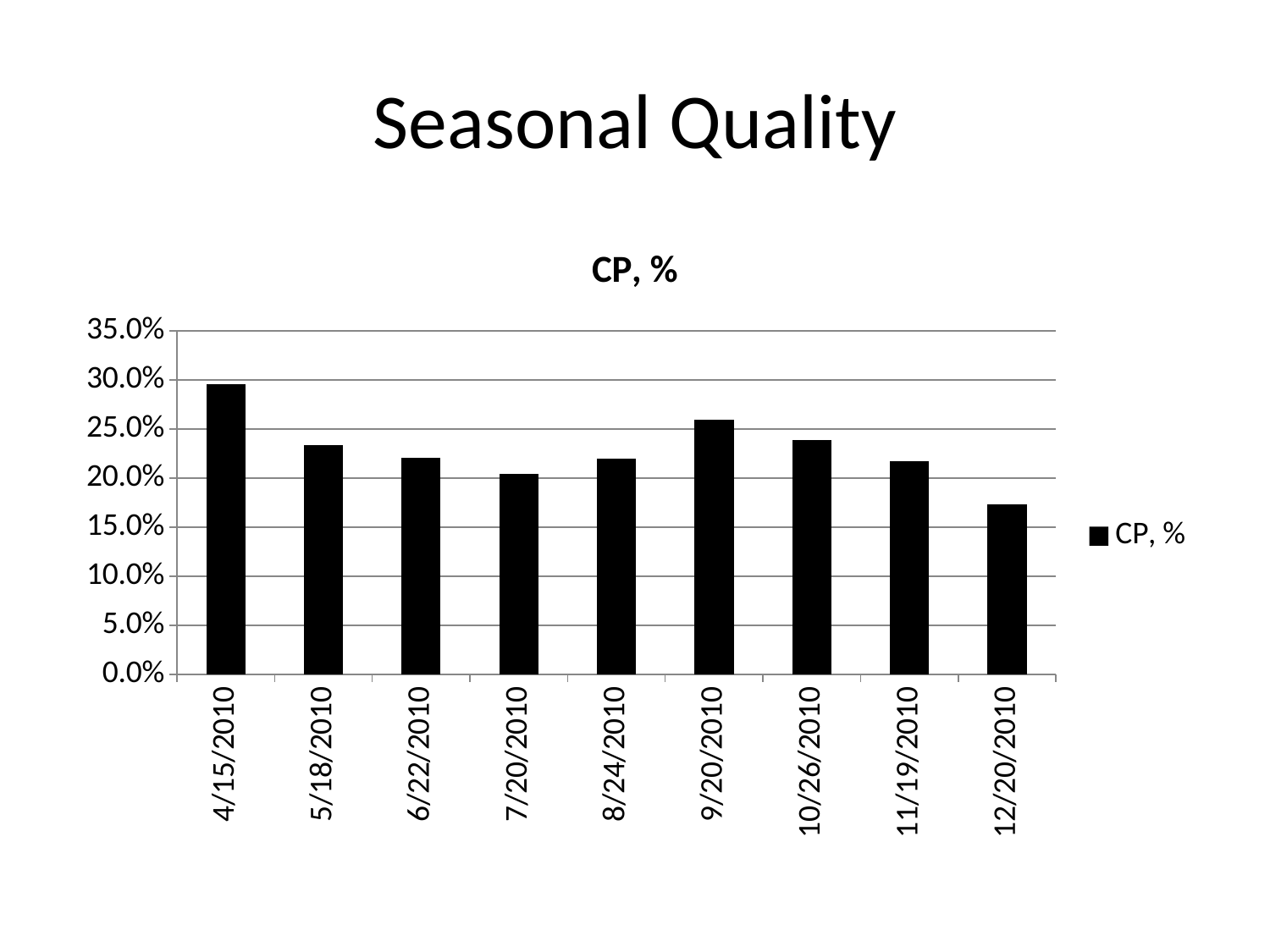
Is the CP, % value for 12/20/2010 greater or less than 20.0%? less Is the CP, % value for 7/20/2010 greater or less than 25.0%? less What is the title of the chart? CP, % Which has a larger CP, % value, 9/20/2010 or 7/20/2010? 9/20/2010 Which date has the lowest CP, % value? 12/20/2010 Is the CP, % value for 4/15/2010 greater or less than 25.0%? greater How many dates are plotted on the x axis of the chart? 9 What kind of chart is shown on the slide? bar chart How many series does the legend list? 1 Which date has the highest CP, % value? 4/15/2010 What is the title of the slide? Seasonal Quality